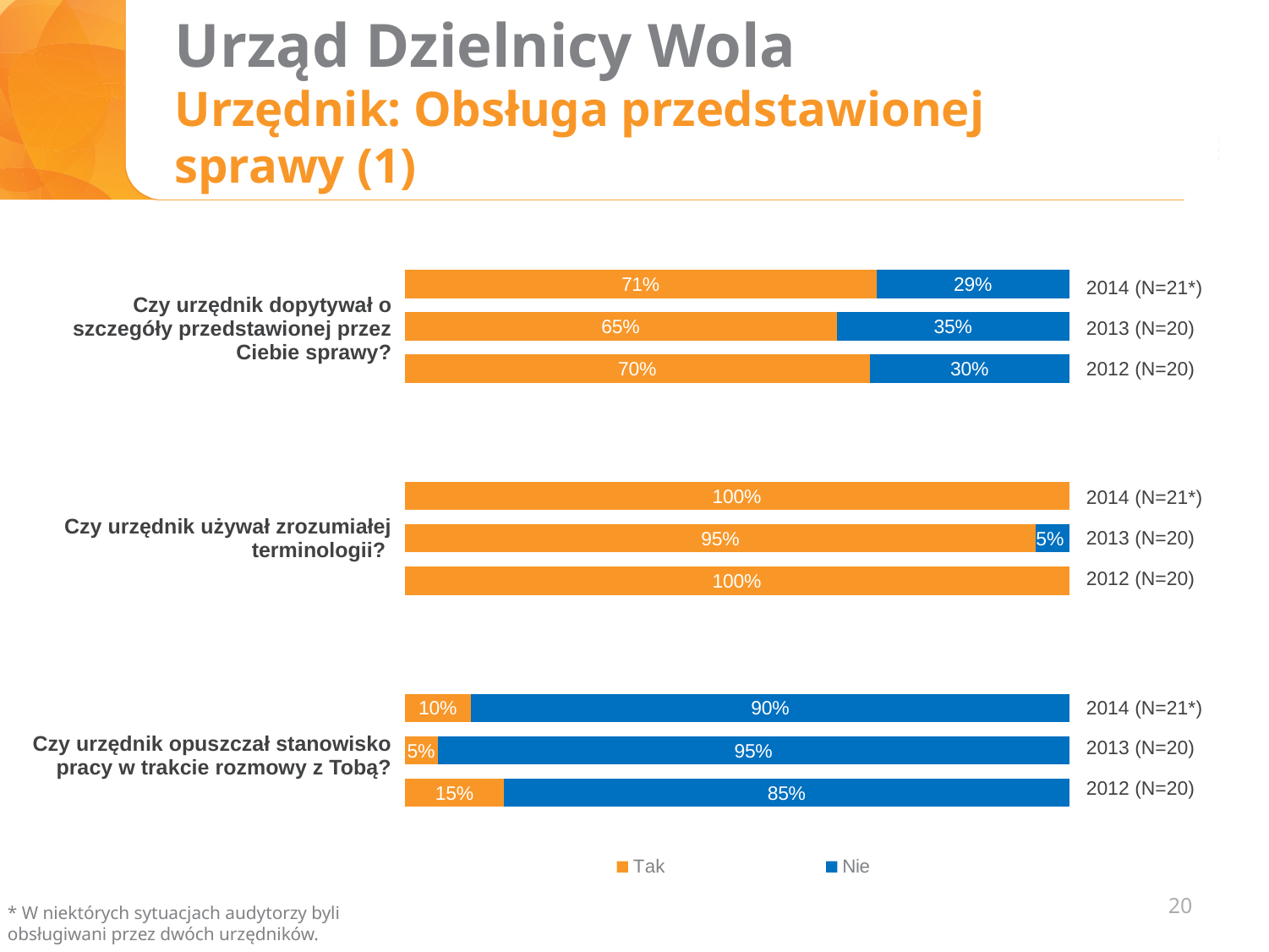
In the chart for "Czy urzędnik opuszczał stanowisko pracy w trakcie rozmowy z Tobą?", which year has the highest "Tak" value? 2012 (N=20) How many series does the legend list? 2 In the chart for "Czy urzędnik dopytywał o szczegóły przedstawionej przez Ciebie sprawy?", what is the "Nie" value for 2013 (N=20)? 35% In the chart for "Czy urzędnik używał zrozumiałej terminologii?", what is the "Tak" value for 2013 (N=20)? 95% In the chart for "Czy urzędnik dopytywał o szczegóły przedstawionej przez Ciebie sprawy?", what is the "Tak" value for 2014 (N=21*)? 71% In the chart for "Czy urzędnik opuszczał stanowisko pracy w trakcie rozmowy z Tobą?", is the "Nie" value for 2014 larger or smaller than the "Nie" value for 2013? smaller In the chart for "Czy urzędnik używał zrozumiałej terminologii?", which year has the lowest "Tak" value? 2013 (N=20) In the chart for "Czy urzędnik dopytywał o szczegóły przedstawionej przez Ciebie sprawy?", what is the difference between the "Tak" values for 2014 and 2013? 6 percentage points In the chart for "Czy urzędnik dopytywał o szczegóły przedstawionej przez Ciebie sprawy?", which year has the highest "Tak" value? 2014 (N=21*) What kind of chart is used on the slide? Stacked bar chart How many years are shown in the chart for "Czy urzędnik używał zrozumiałej terminologii?"? 3 In the chart for "Czy urzędnik opuszczał stanowisko pracy w trakcie rozmowy z Tobą?", what is the "Nie" value for 2012 (N=20)? 85%